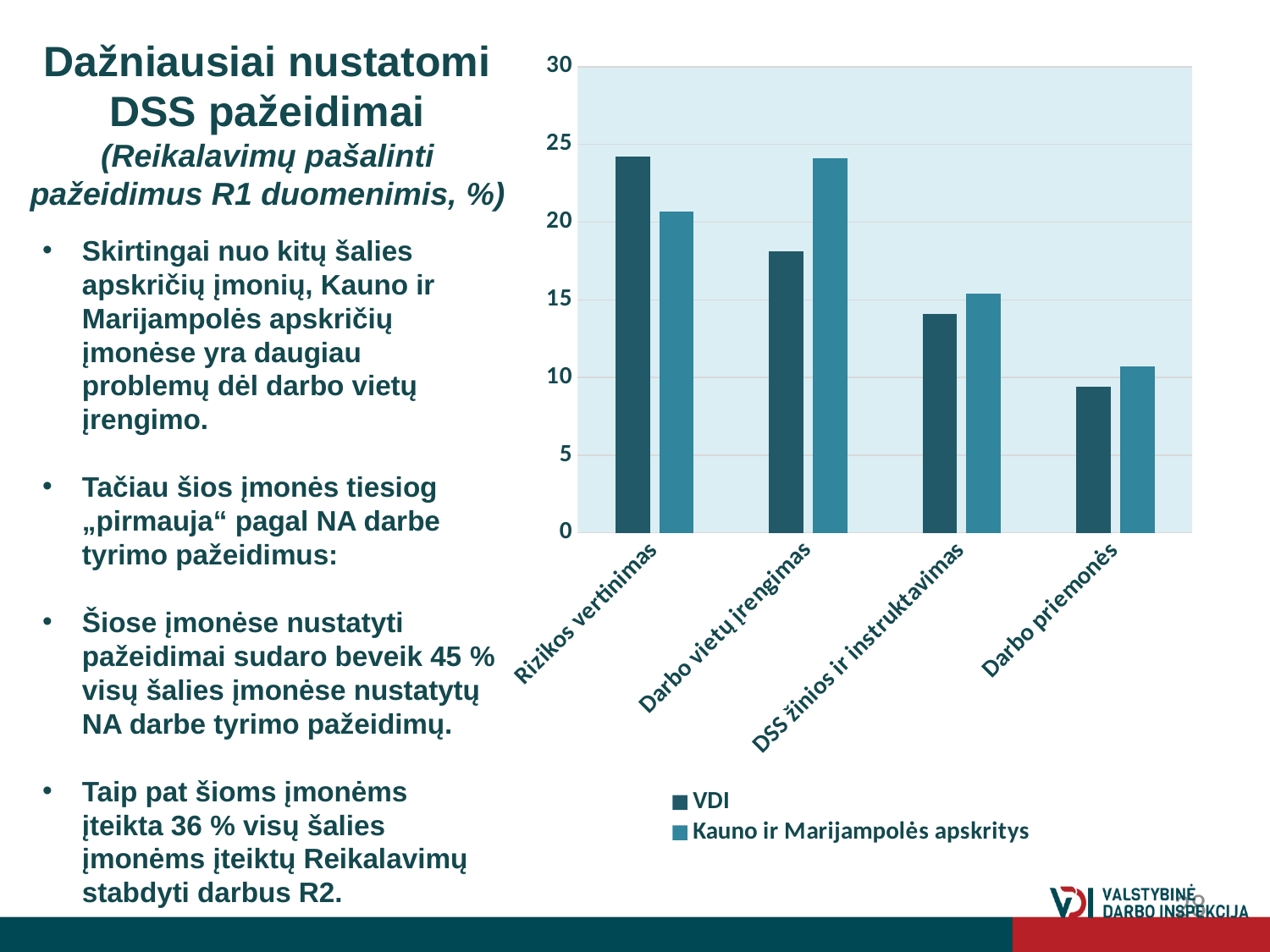
Do the VDI values rise or fall from left to right along the x axis? fall Which category has the lowest value for the VDI series? Darbo priemonės Is the VDI value for Rizikos vertinimas greater or less than 20? greater How many series does the legend list? 2 How many categories are shown on the x axis? 4 For Darbo vietų įrengimas, which series has the larger value, VDI or Kauno ir Marijampolės apskritys? Kauno ir Marijampolės apskritys What are the two series named in the legend? VDI; Kauno ir Marijampolės apskritys Which category has the highest value for the Kauno ir Marijampolės apskritys series? Darbo vietų įrengimas Is the VDI value for Darbo priemonės greater or less than 10? less For Rizikos vertinimas, which series has the larger value, VDI or Kauno ir Marijampolės apskritys? VDI What kind of chart is shown on the slide? bar chart Which category has the highest value for the VDI series? Rizikos vertinimas